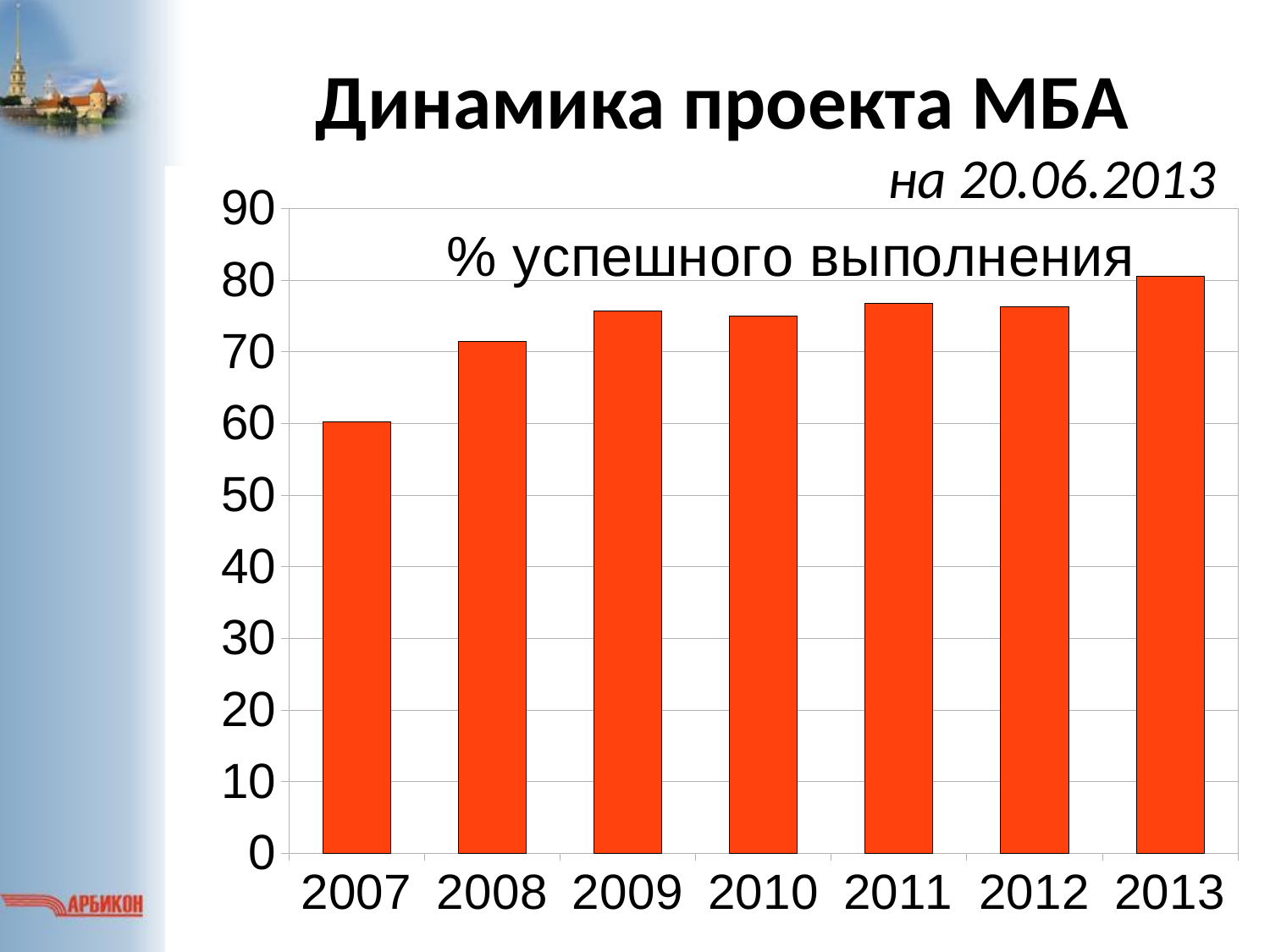
How many years (bars) are shown on the chart? 7 Is the value for 2007 greater or less than 70? less Is the value for 2011 greater or less than 80? less What kind of chart is shown on the slide? bar chart Do the values generally rise or fall from 2007 to 2013? rise Which year has the highest value on the chart? 2013 Which is larger, the value for 2007 or the value for 2008? 2008 Which is larger, the value for 2012 or the value for 2013? 2013 What is the title of the chart inside the plot area? % успешного выполнения Is the value for 2008 greater or less than 70? greater Which year has the lowest value on the chart? 2007